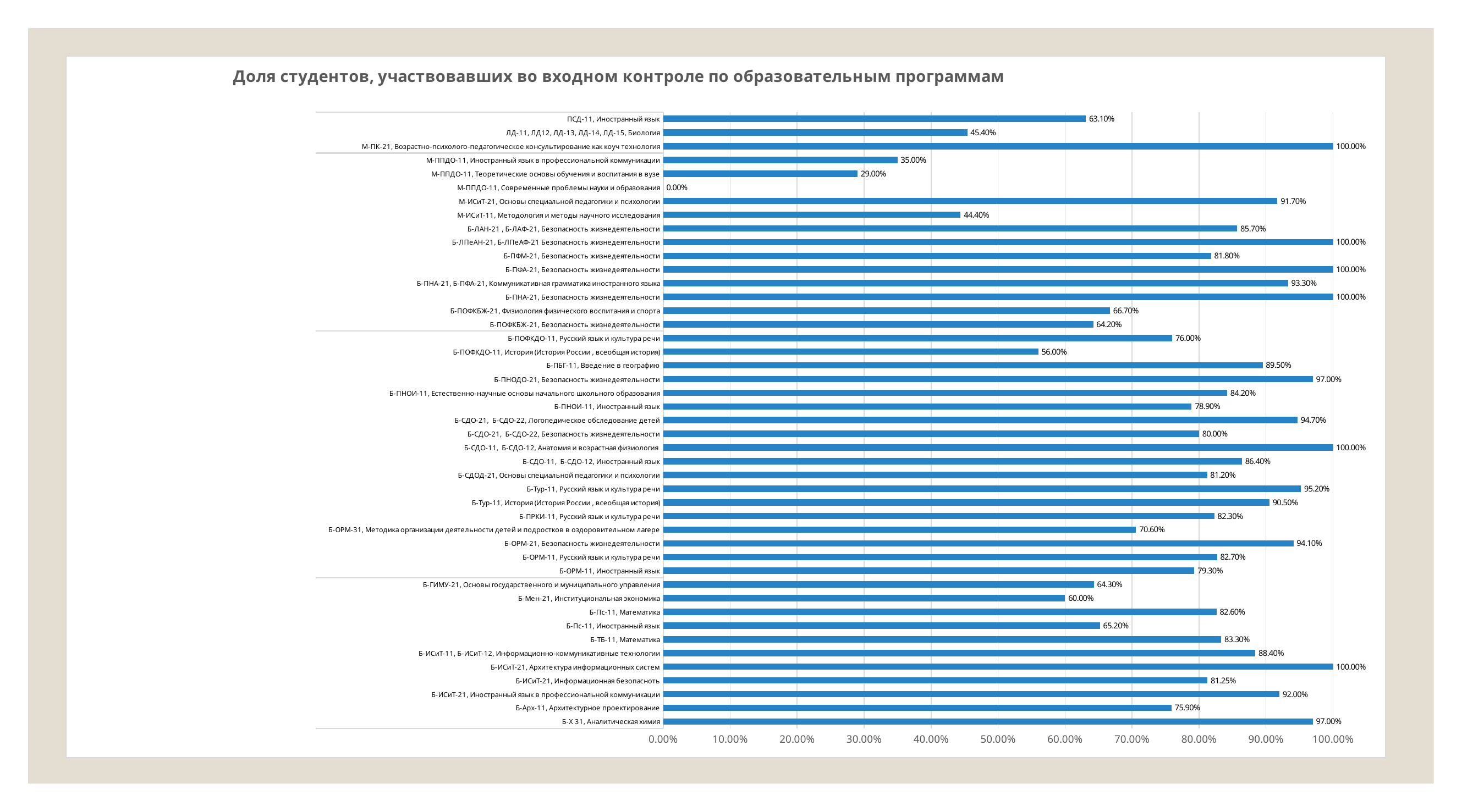
How many categories are plotted on the chart? 45 What is the value for ЛД-11, ЛД12, ЛД-13, ЛД-14, ЛД-15, Биология? 45.40% Which category has the lowest value? М-ППДО-11, Современные проблемы науки и образования How many categories reach exactly 100.00%? 6 What is the value for Б-Х 31, Аналитическая химия? 97.00% What type of chart is shown on the slide? bar chart What is the value for Б-ОРМ-31, Методика организации деятельности детей и подростков в оздоровительном лагере? 70.60% What is the difference between the values for Б-Тур-11, Русский язык и культура речи and Б-Тур-11, История (История России, всеобщая история)? 4.70% Which is larger: the value for Б-Пс-11, Математика or the value for Б-Пс-11, Иностранный язык? Б-Пс-11, Математика What is the value for Б-ИСиТ-21, Информационная безопасность? 81.25% What is the title of the chart? Доля студентов, участвовавших во входном контроле по образовательным программам Is the value for Б-Мен-21, Институциональная экономика greater or less than 70.00%? less